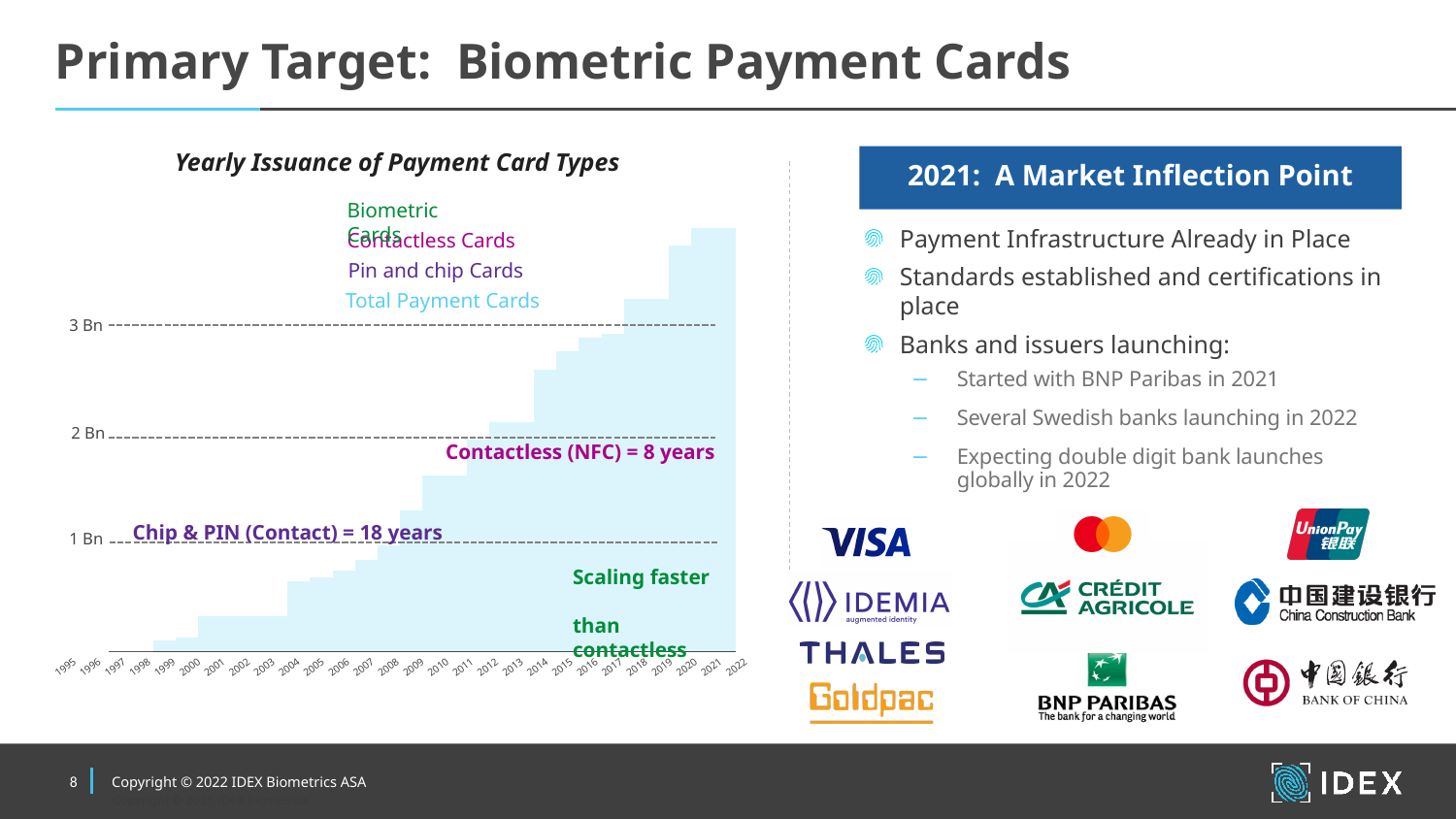
How many years are labelled on the x axis of the Yearly Issuance of Payment Card Types chart? 28 In the Yearly Issuance of Payment Card Types chart, which year has the larger total payment cards value, 2010 or 2022? 2022 In the Yearly Issuance of Payment Card Types chart, is the total payment cards value for 2017 greater or less than 2 Bn? greater In the Yearly Issuance of Payment Card Types chart, is the total payment cards value for 2010 greater or less than 2 Bn? less In the Yearly Issuance of Payment Card Types chart, is the total payment cards value for 2005 greater or less than 1 Bn? less According to the annotation on the Yearly Issuance of Payment Card Types chart, how many years did Chip & PIN (Contact) take? 18 years How many entries does the legend of the Yearly Issuance of Payment Card Types chart list? 4 In the Yearly Issuance of Payment Card Types chart, do the total payment card values rise or fall from 1995 to 2022? rise What is the title of the chart on the left of the slide? Yearly Issuance of Payment Card Types In the Yearly Issuance of Payment Card Types chart, which year has the highest total payment cards value? 2021 and 2022 (tied)